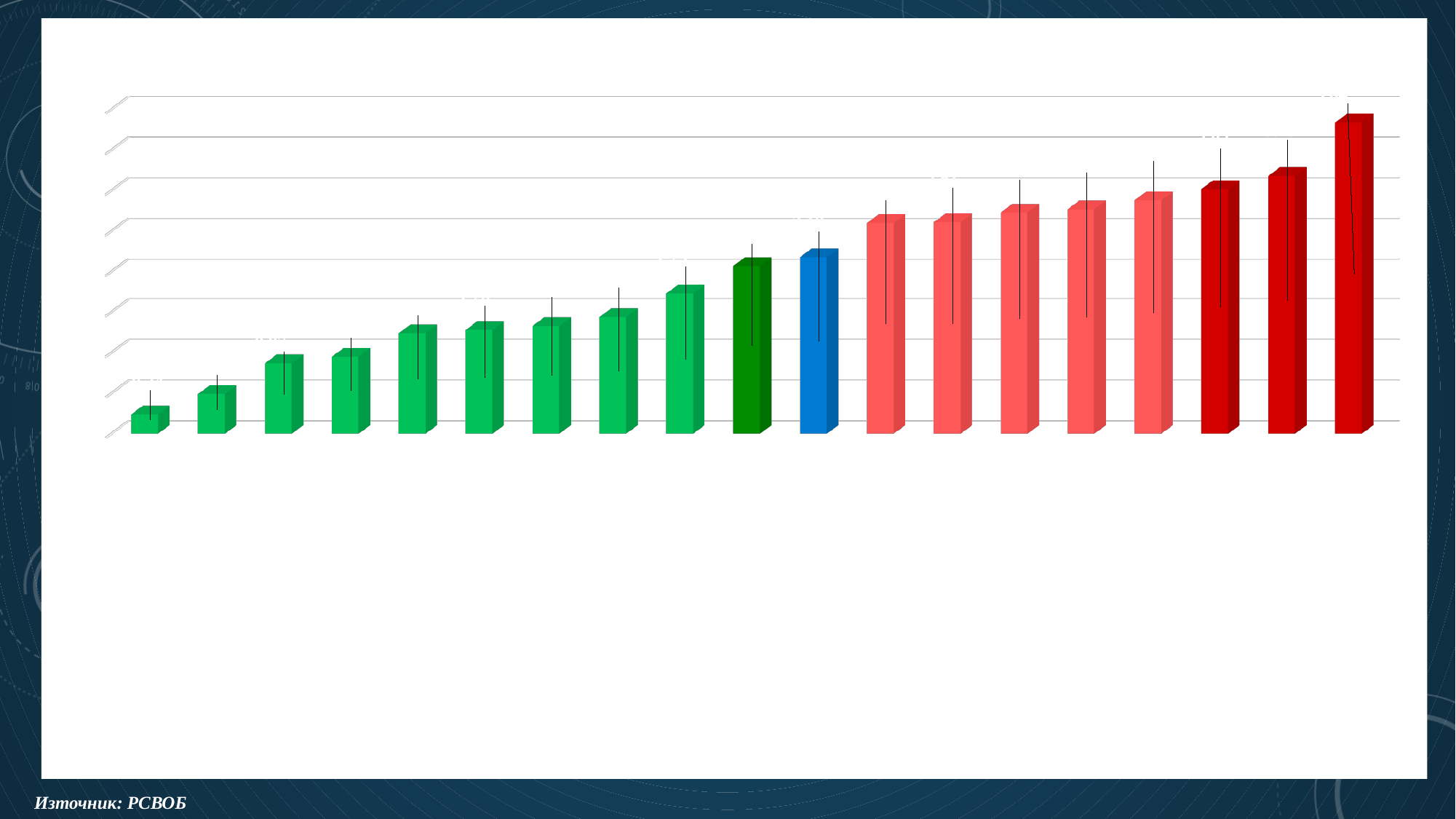
Do the bar values rise or fall from left to right across the chart? rise How many bars in the chart are coloured blue? 1 What kind of chart is shown on the slide? bar chart Which bar is the tallest in the chart? the rightmost bar Which bar is the shortest in the chart? the leftmost bar What source is cited at the bottom of the slide? РСВОБ How many bars does the chart contain? 19 Is the blue bar taller or shorter than the dark green bar immediately to its left? taller Is the leftmost bar taller or shorter than the rightmost bar? shorter